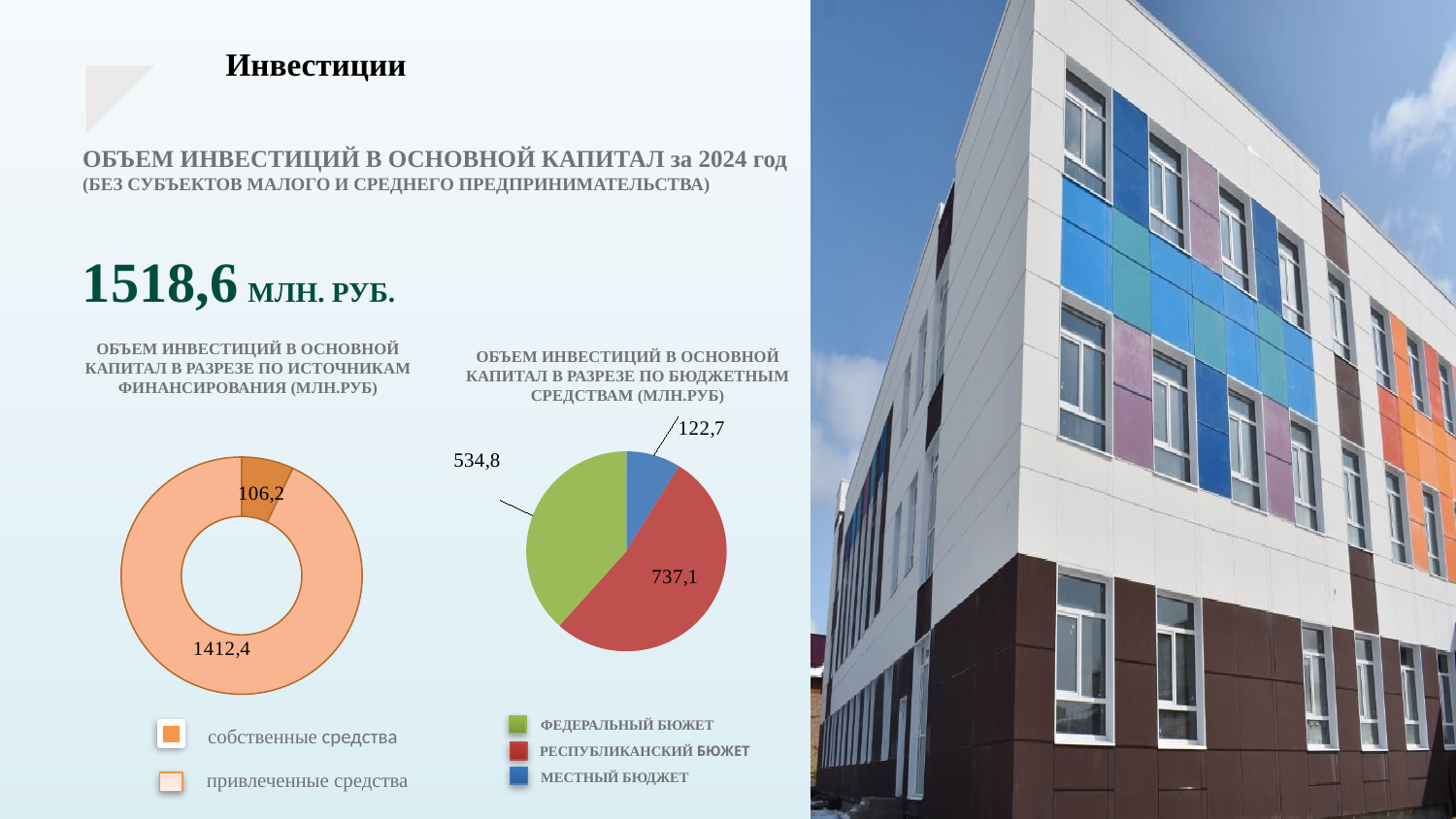
In the right chart (by budget funds), what is the value for федеральный бюджет? 534,8 In the left chart (by sources of financing), what is the value for привлеченные средства? 1412,4 In the right chart (by budget funds), what is the value for республиканский бюджет? 737,1 In the right chart (by budget funds), what is the difference between республиканский бюджет and федеральный бюджет? 202,3 In the right chart (by budget funds), which is larger: федеральный бюджет or местный бюджет? федеральный бюджет In the left chart (by sources of financing), what is the value for собственные средства? 106,2 In the right chart (by budget funds), which budget has the smallest value? местный бюджет In the right chart (by budget funds), what is the value for местный бюджет? 122,7 In the right chart (by budget funds), which budget has the largest value? республиканский бюджет What type of chart is the right chart (by budget funds)? pie chart How many categories does the right chart (by budget funds) show? 3 In the left chart (by sources of financing), what is the difference between привлеченные средства and собственные средства? 1306,2